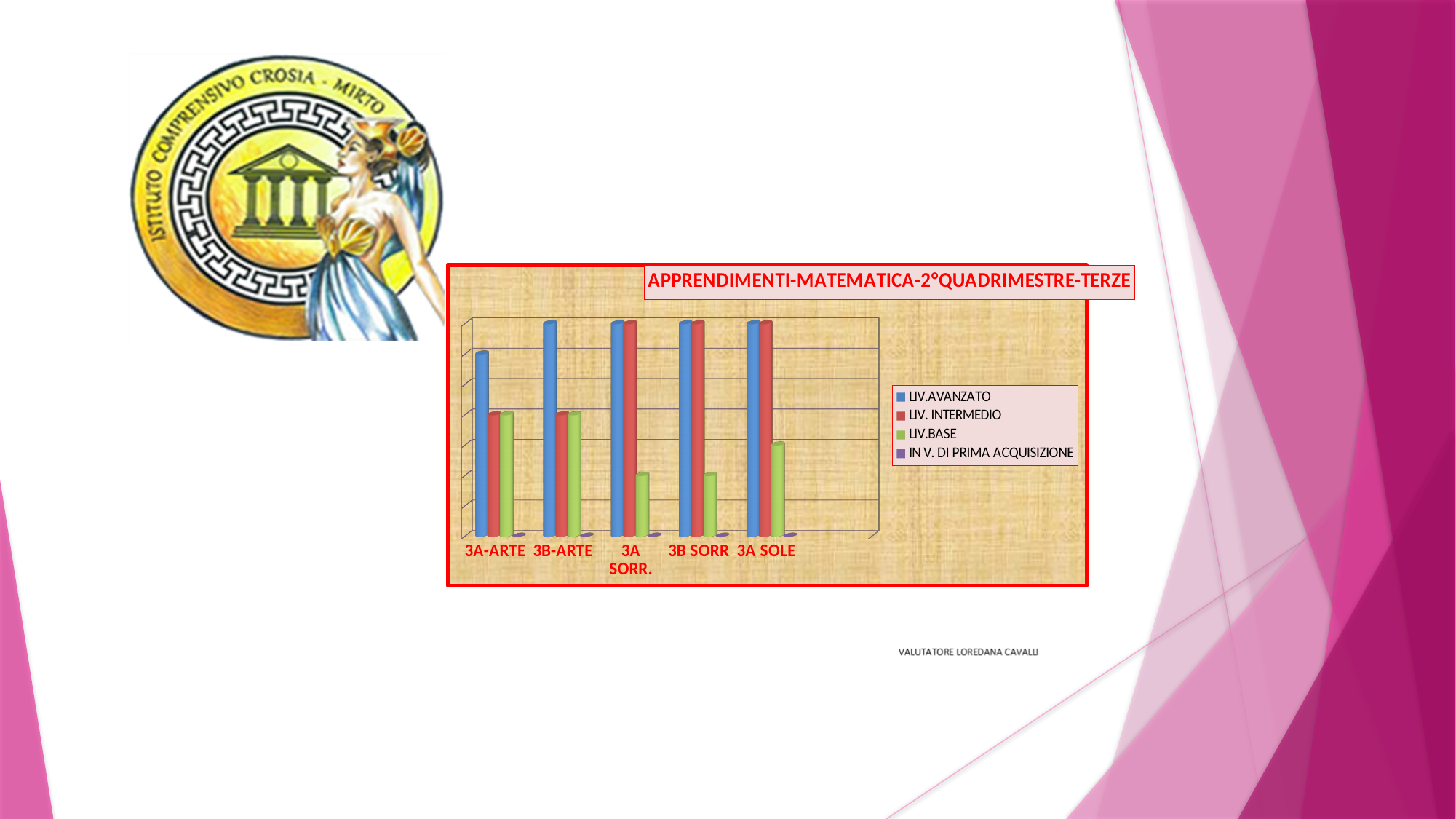
Which class has the lowest LIV.AVANZATO value? 3A-ARTE What kind of chart is shown on the slide? bar chart Which is larger: the LIV.BASE value for 3A SOLE or the LIV.BASE value for 3B SORR? 3A SOLE Which series is shown in blue in the legend? LIV.AVANZATO Which series has the highest value in every class? LIV.AVANZATO How many series does the legend list? 4 For 3A SORR., which is larger: LIV.BASE or LIV. INTERMEDIO? LIV. INTERMEDIO What is the title of the chart? APPRENDIMENTI-MATEMATICA-2°QUADRIMESTRE-TERZE Which series has the lowest value in every class? IN V. DI PRIMA ACQUISIZIONE For 3A-ARTE, which is larger: LIV.AVANZATO or LIV.BASE? LIV.AVANZATO How many classes (categories) are shown on the x axis? 5